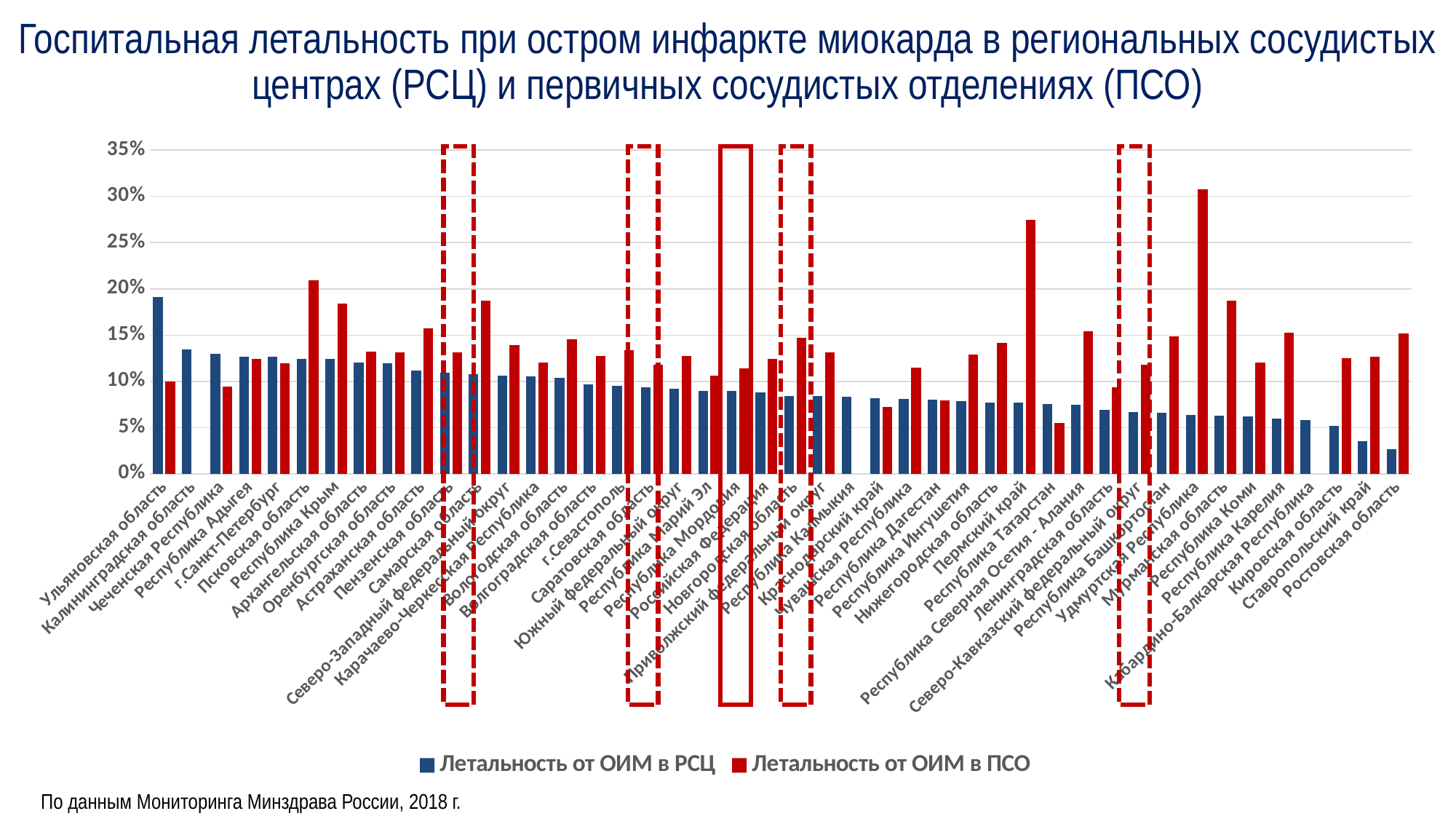
Is the 'Летальность от ОИМ в ПСО' value for Республика Татарстан greater or less than 10%? less Do the 'Летальность от ОИМ в РСЦ' values generally rise or fall from left to right along the x axis? Fall What kind of chart is shown on the slide? Bar chart For Мурманская область, which is larger: the РСЦ value or the ПСО value? ПСО Which colour represents 'Летальность от ОИМ в ПСО'? Red How many series does the legend list? 2 Which region has the highest value for 'Летальность от ОИМ в ПСО'? Удмуртская Республика Which region has the highest value for 'Летальность от ОИМ в РСЦ'? Ульяновская область Which region has the lowest value for 'Летальность от ОИМ в РСЦ'? Ростовская область Is the 'Летальность от ОИМ в ПСО' value for Пермский край greater or less than 25%? greater What are the two series named in the legend? Летальность от ОИМ в РСЦ; Летальность от ОИМ в ПСО Is the 'Летальность от ОИМ в РСЦ' value for Ульяновская область greater or less than 15%? greater